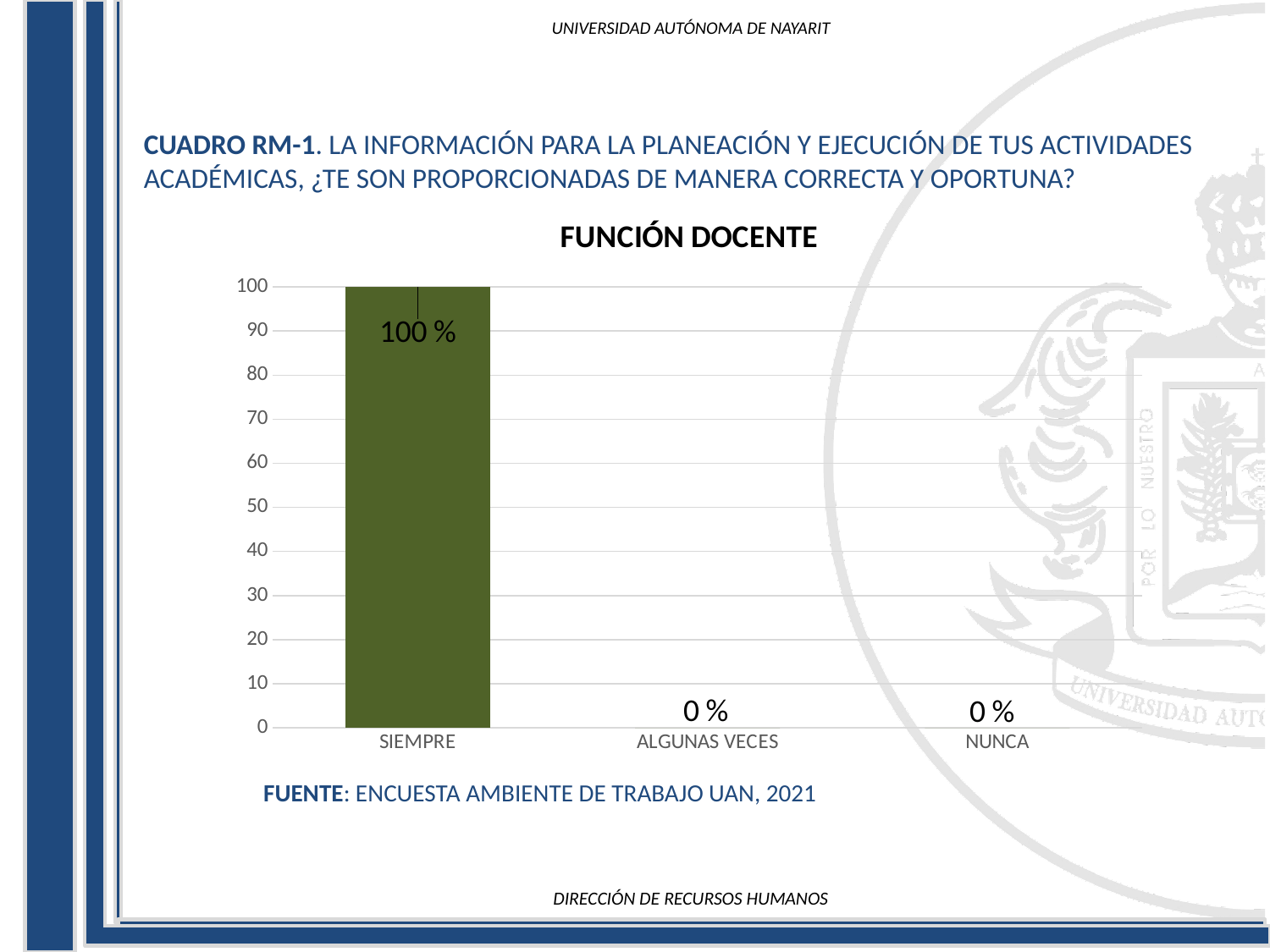
Which category has the highest value? SIEMPRE Is the value for SIEMPRE greater or less than 50? greater What is the value for ALGUNAS VECES? 0 % What is the highest value shown on the y axis? 100 What is the title of the chart? FUNCIÓN DOCENTE What is the difference between the values for SIEMPRE and NUNCA? 100 % What kind of chart is shown? bar chart How many categories are shown on the x axis? 3 Do the values rise or fall from SIEMPRE to ALGUNAS VECES? fall Which is larger, the value for SIEMPRE or the value for ALGUNAS VECES? SIEMPRE What is the value for SIEMPRE? 100 % What is the value for NUNCA? 0 %